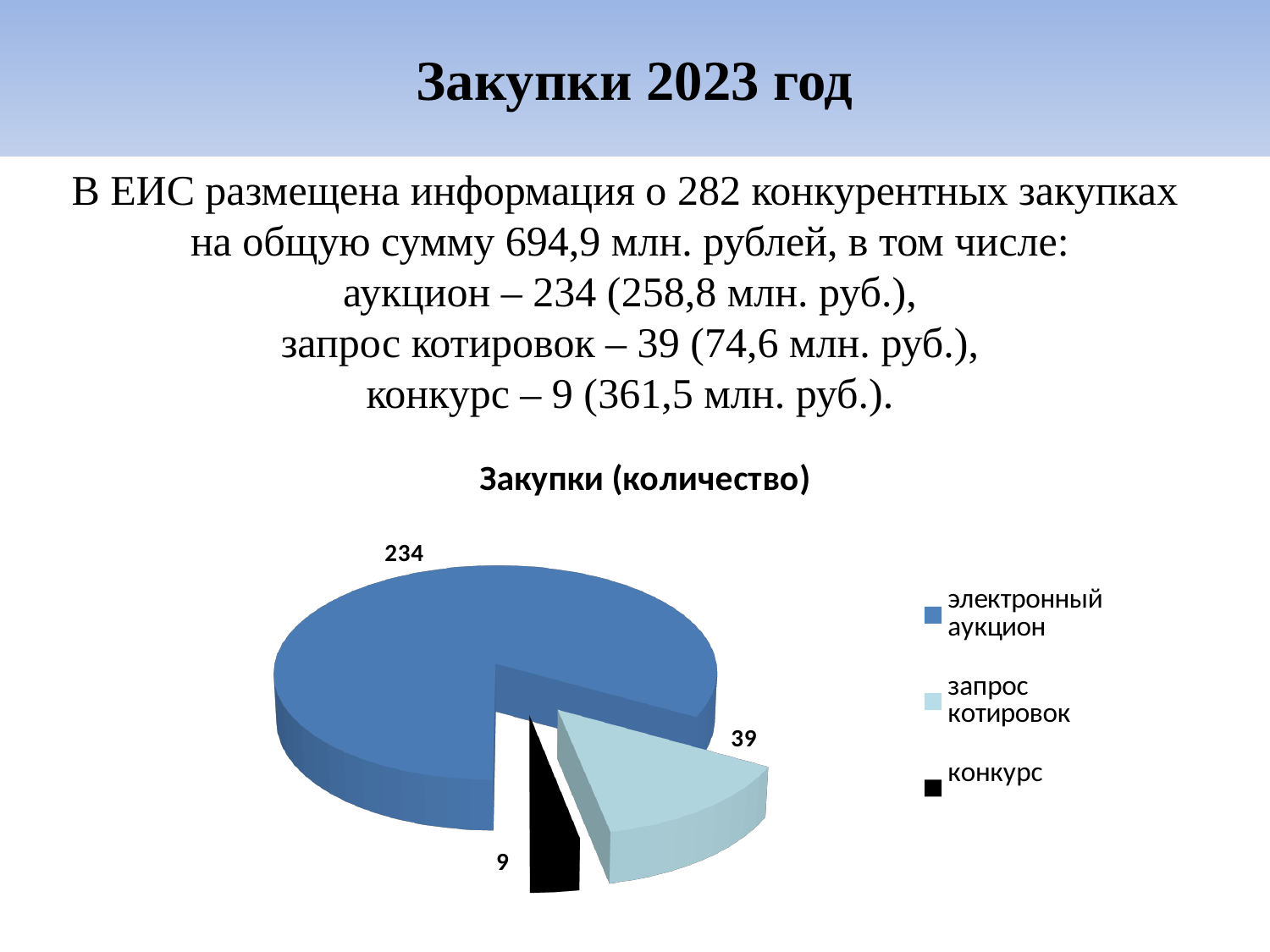
Which category has the smallest slice in the pie chart? конкурс Which is larger, the value for запрос котировок or the value for конкурс? запрос котировок What colour is the slice for конкурс? black Which category has the largest slice in the pie chart? электронный аукцион What is the value for конкурс in the pie chart? 9 What is the title of the chart? Закупки (количество) How many entries does the chart legend list? 3 What is the difference between the values for электронный аукцион and запрос котировок? 195 How many slices does the pie chart have? 3 What is the value for электронный аукцион in the pie chart? 234 What type of chart is shown on the slide? pie chart What is the value for запрос котировок in the pie chart? 39